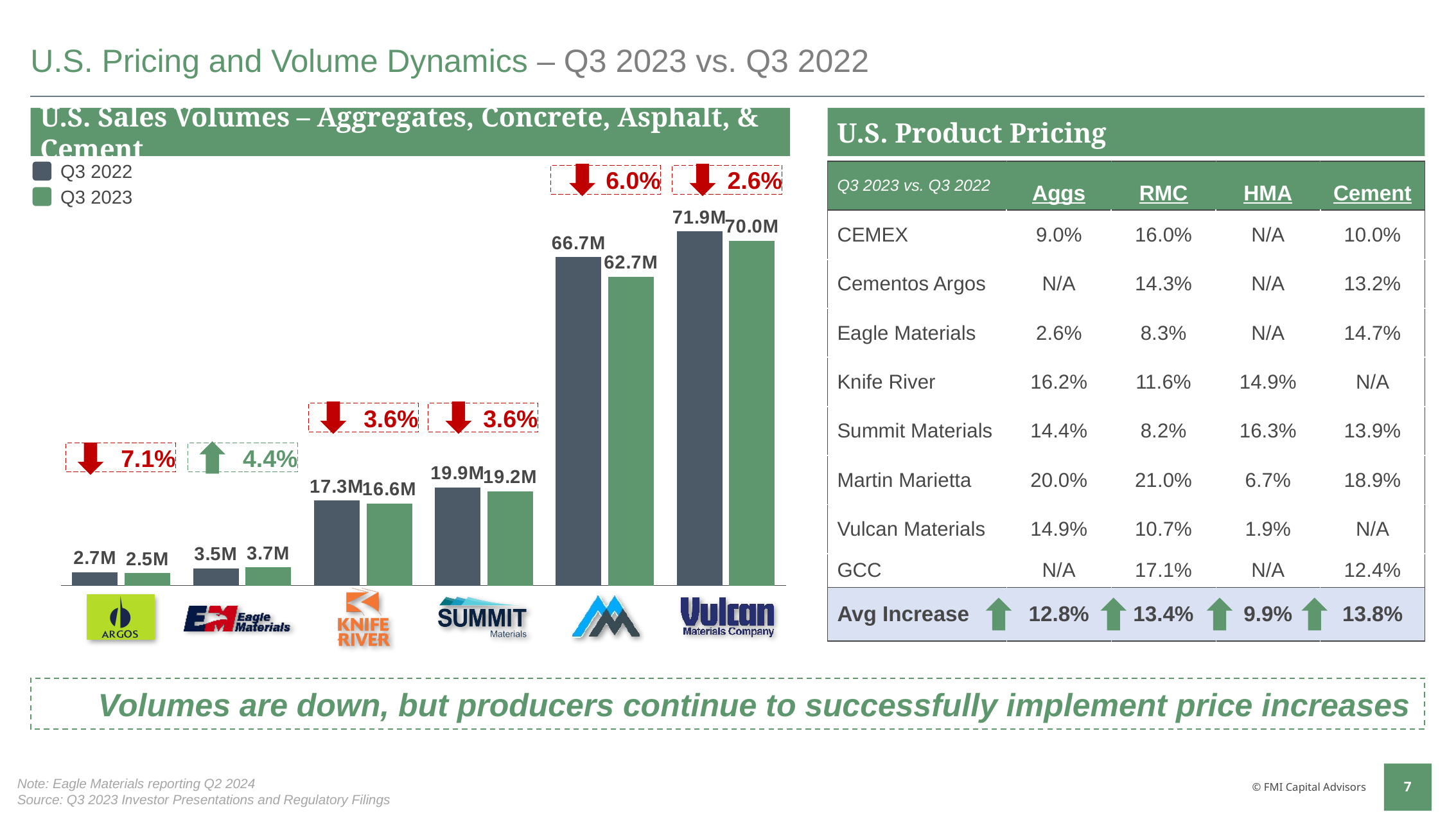
In the U.S. Sales Volumes chart, which company has the highest Q3 2022 volume? Vulcan Materials In the U.S. Sales Volumes chart, what is the Q3 2023 value for Vulcan Materials? 70.0M What kind of chart is the U.S. Sales Volumes chart? bar chart In the U.S. Sales Volumes chart, what is the Q3 2022 value for Knife River? 17.3M In the U.S. Sales Volumes chart, is Eagle Materials' Q3 2023 volume larger or smaller than its Q3 2022 volume? larger In the U.S. Sales Volumes chart, which colour represents Q3 2023? green How many series does the legend of the U.S. Sales Volumes chart list? 2 In the U.S. Sales Volumes chart, what is the Q3 2023 value for Eagle Materials? 3.7M In the U.S. Sales Volumes chart, what is the difference between Summit Materials' Q3 2022 and Q3 2023 volumes? 0.7M In the U.S. Sales Volumes chart, which company has the lowest Q3 2023 volume? Argos In the U.S. Sales Volumes chart, what percentage change is shown above the Argos bars? 7.1% How many companies are shown on the x axis of the U.S. Sales Volumes chart? 6